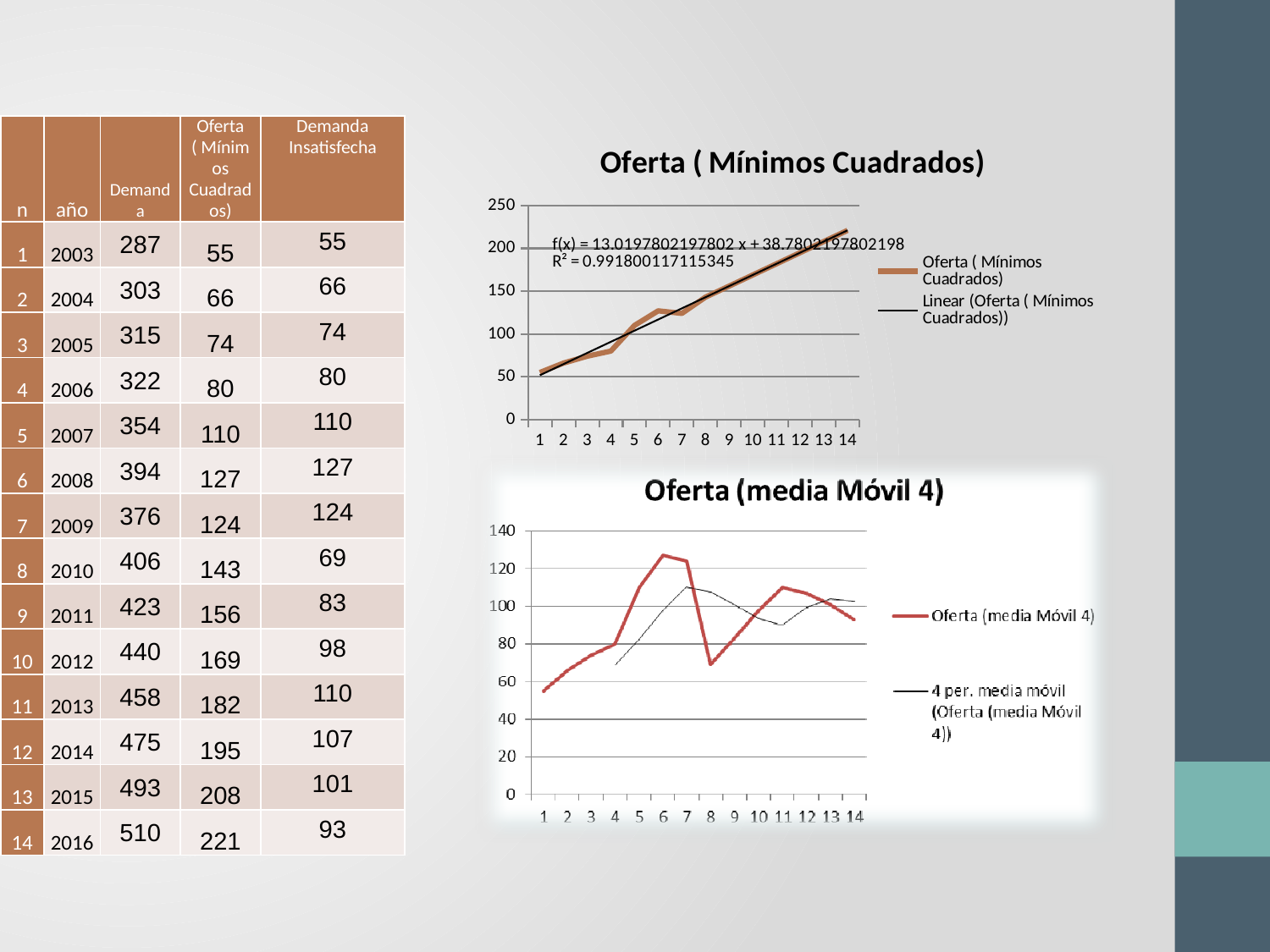
How many points are plotted along the x axis of the "Oferta ( Mínimos Cuadrados)" chart? 14 What type of chart is the "Oferta ( Mínimos Cuadrados)" chart? line chart How many series does the legend of the "Oferta ( Mínimos Cuadrados)" chart list? 2 In the "Oferta ( Mínimos Cuadrados)" chart, is the value at point 14 greater or less than 200? greater What R² value is printed on the "Oferta ( Mínimos Cuadrados)" chart? 0.991800117115345 In the "Oferta (media Móvil 4)" chart, is the value at point 6 on the Oferta (media Móvil 4) line greater or less than 120? greater In the "Oferta ( Mínimos Cuadrados)" chart, is the value at point 4 greater or less than 100? less In the "Oferta (media Móvil 4)" chart, which is larger on the Oferta (media Móvil 4) line: the value at point 6 or at point 8? point 6 How many series does the legend of the "Oferta (media Móvil 4)" chart list? 2 In the "Oferta (media Móvil 4)" chart, which point has the lowest value on the Oferta (media Móvil 4) line? 1 In the "Oferta ( Mínimos Cuadrados)" chart, do the values rise or fall from point 1 to point 14? rise